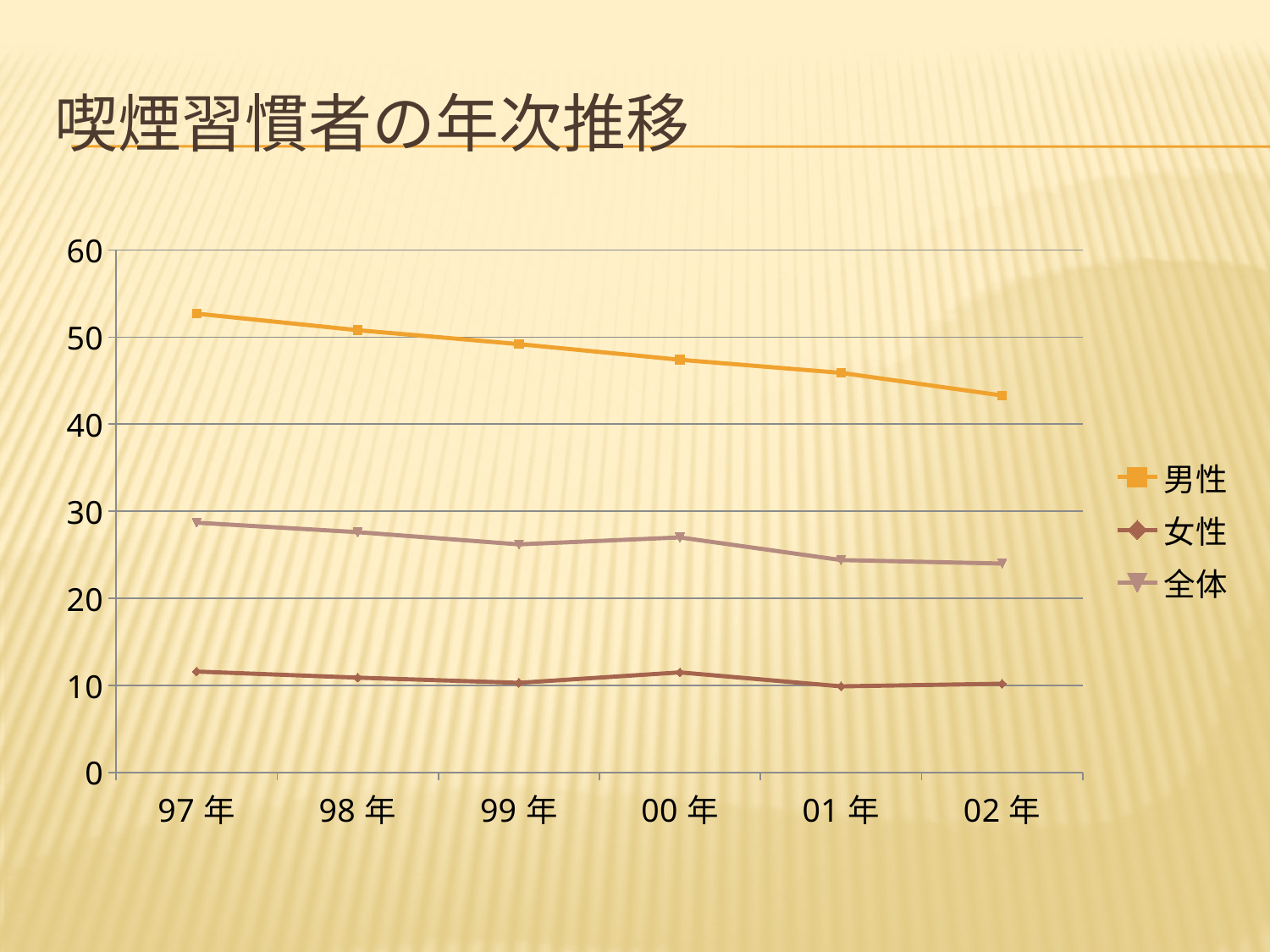
Is the 男性 value for 02年 greater or less than 50? less Which series is plotted with the lowest values across all years? 女性 Is the 全体 value for 02年 greater or less than 30? less How many years are plotted along the x axis? 6 In which year is the 男性 value highest? 97年 In which year is the 男性 value lowest? 02年 What is the title of the slide? 喫煙習慣者の年次推移 Which series has the higher value in 00年, 女性 or 全体? 全体 How many series does the legend list? 3 Does the 男性 series rise or fall from 97年 to 02年? fall What kind of chart is shown on the slide? line chart Is the 男性 value for 97年 greater or less than 50? greater